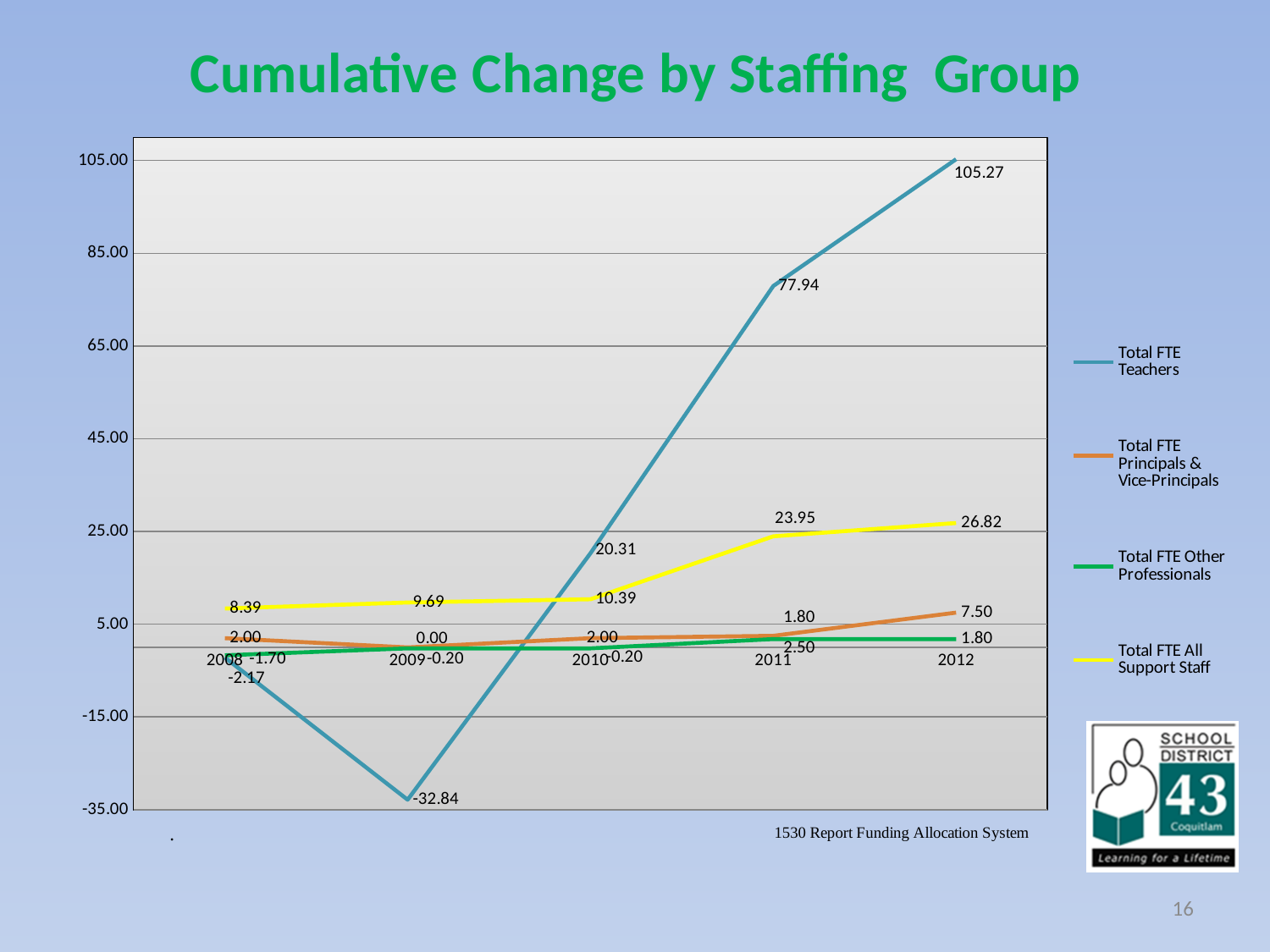
What kind of chart is shown on the slide? line chart What is the value for Total FTE Teachers in 2012? 105.27 In 2012, which is larger: Total FTE All Support Staff or Total FTE Principals & Vice-Principals? Total FTE All Support Staff What is the value for Total FTE Principals & Vice-Principals in 2012? 7.50 In which year is the Total FTE Teachers value highest? 2012 How many series does the legend list? 4 What is the value for Total FTE Teachers in 2009? -32.84 Does the Total FTE All Support Staff line rise or fall from 2008 to 2012? rise In which year is the Total FTE Teachers value lowest? 2009 How many years are plotted along the x axis? 5 What is the difference between the Total FTE Teachers values for 2012 and 2011? 27.33 What is the value for Total FTE All Support Staff in 2011? 23.95